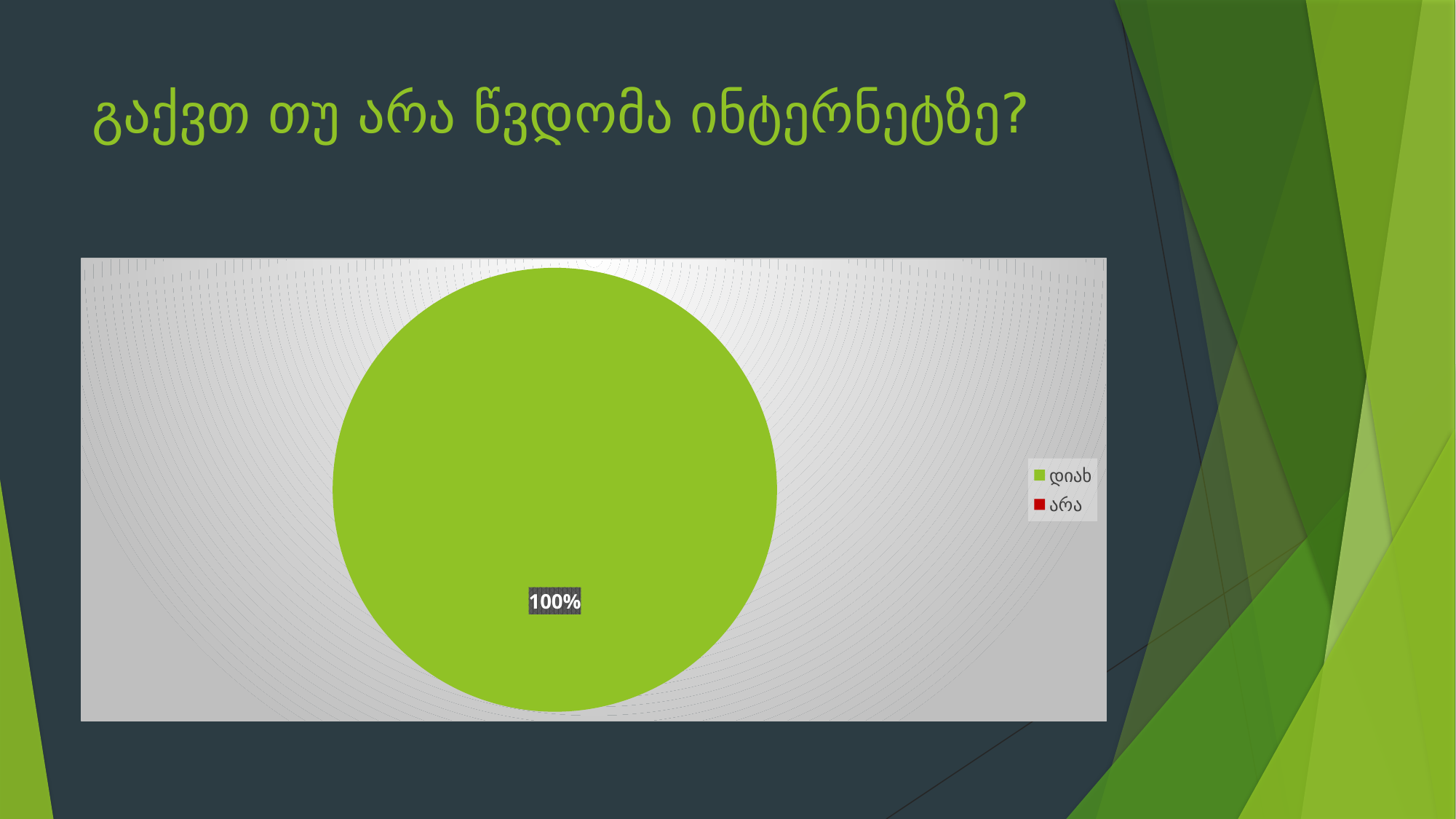
Which of the two legend categories, დიახ or არა, has the larger share of the pie? დიახ What is the title of the slide above the chart? გაქვთ თუ არა წვდომა ინტერნეტზე? Which category has the largest share of the pie? დიახ What share of the pie does the დიახ slice take? 100% How many entries does the legend list? 2 What colour represents დიახ in the legend? green What is the data label printed on the pie? 100% What kind of chart is shown on the slide? pie chart